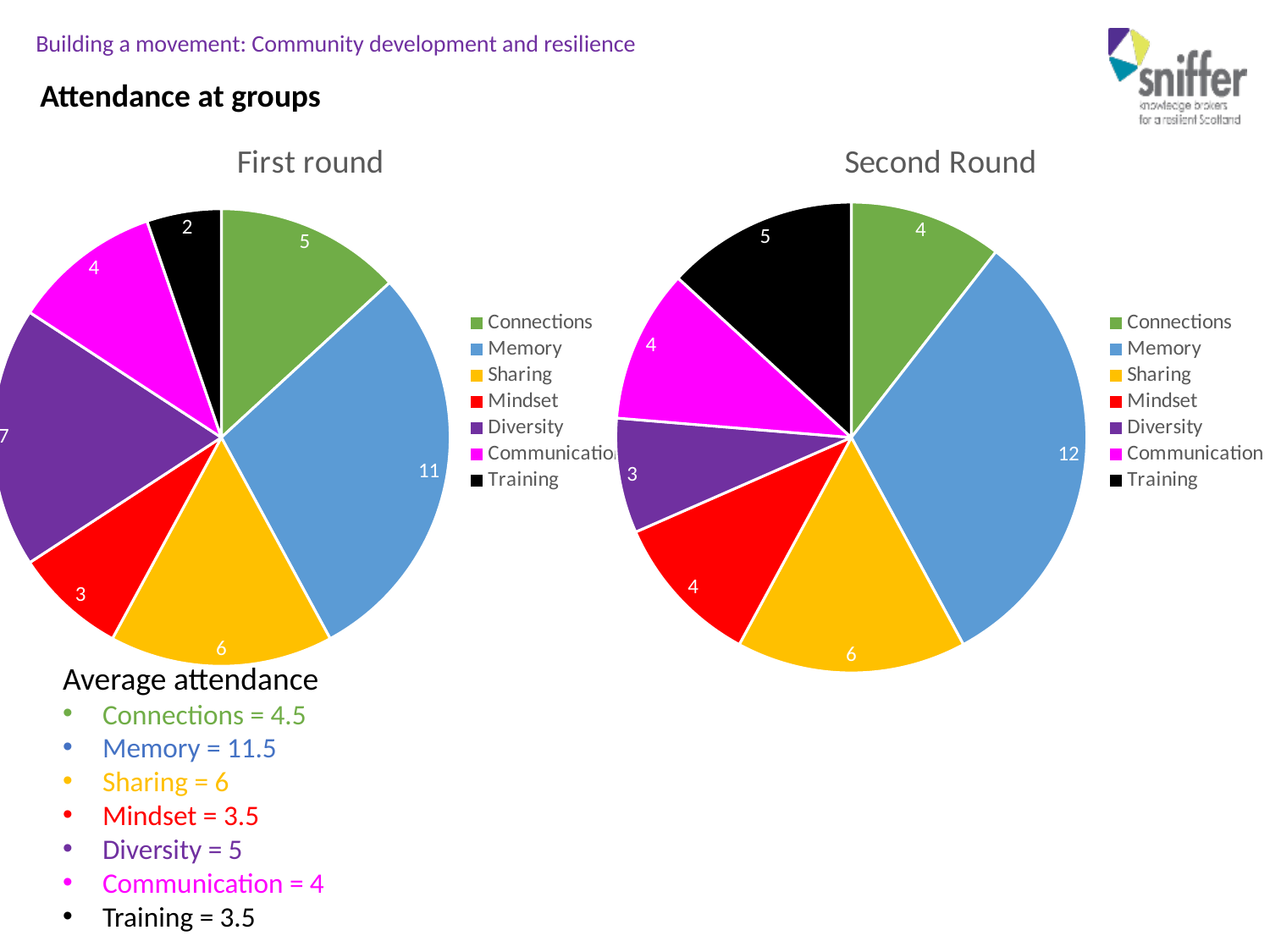
In the First round chart, which category has the largest slice? Memory How many categories does the legend of the Second Round chart list? 7 In the Second Round chart, what is the difference between the values for Memory and Connections? 8 In the First round chart, what is the value for Sharing? 6 In the First round chart, which is larger, Sharing or Mindset? Sharing In the Second Round chart, what is the value for Training? 5 In the First round chart, which category has the smallest slice? Training In the First round chart, what is the difference between the values for Memory and Training? 9 What kind of chart is the First round chart? Pie chart In the First round chart, what is the value for Memory? 11 In the Second Round chart, which category has the smallest slice? Diversity In the Second Round chart, what is the value for Memory? 12